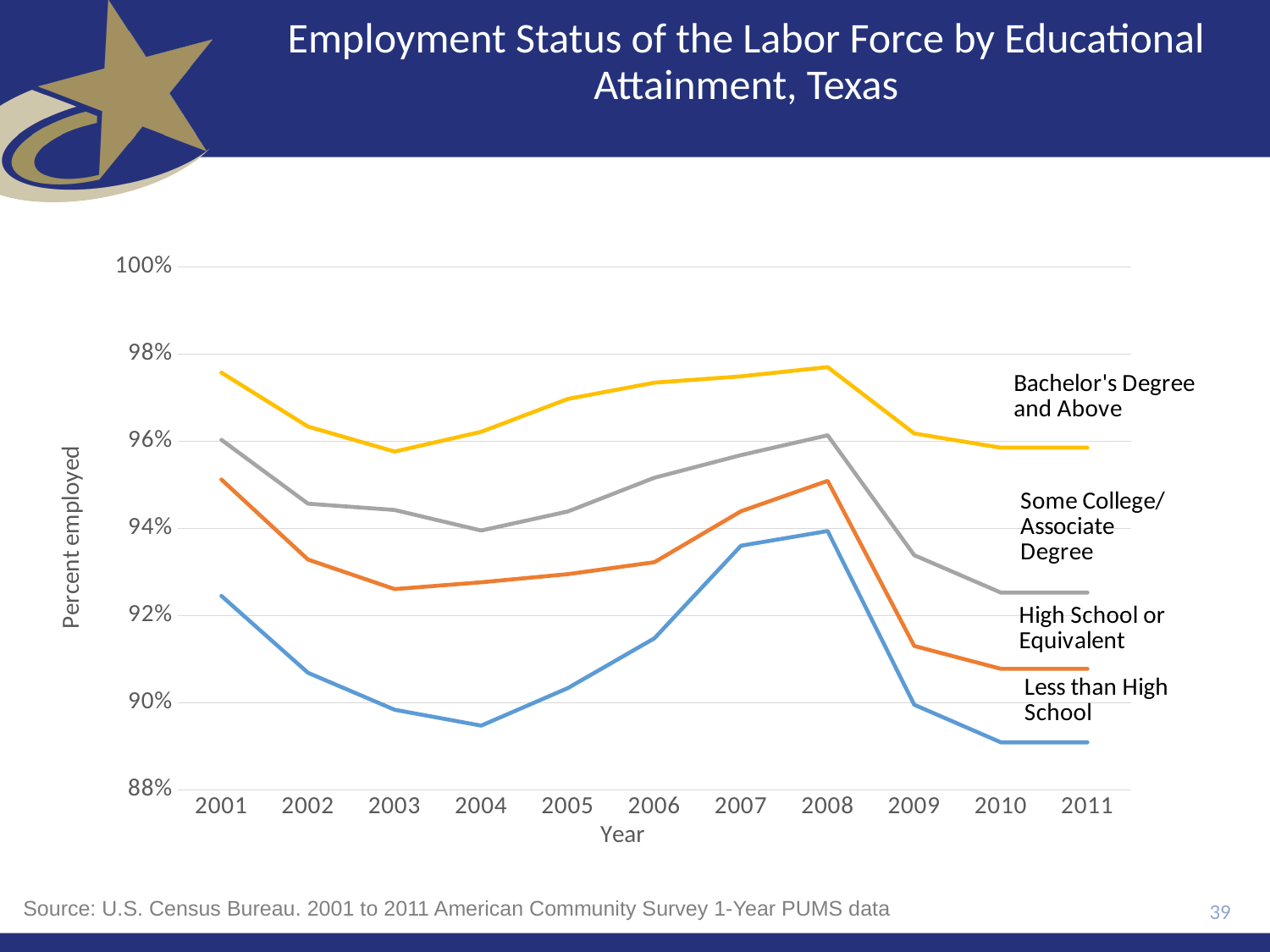
Which educational attainment group has the lowest percent employed across all years shown? Less than High School Is the value for Bachelor's Degree and Above in 2008 greater or less than 96%? greater How many years are plotted along the x axis? 11 Which educational attainment group has the highest percent employed across all years shown? Bachelor's Degree and Above Does the Bachelor's Degree and Above line rise or fall from 2003 to 2008? rise What is the label on the y axis of the chart? Percent employed Is the value for High School or Equivalent in 2009 greater or less than 92%? less How many educational attainment series are plotted on the chart? 4 Does the Less than High School line rise or fall from 2008 to 2010? fall Is the value for Less than High School in 2004 greater or less than 90%? less What kind of chart is shown on the slide? line chart In which year does the Less than High School line reach its highest value? 2008